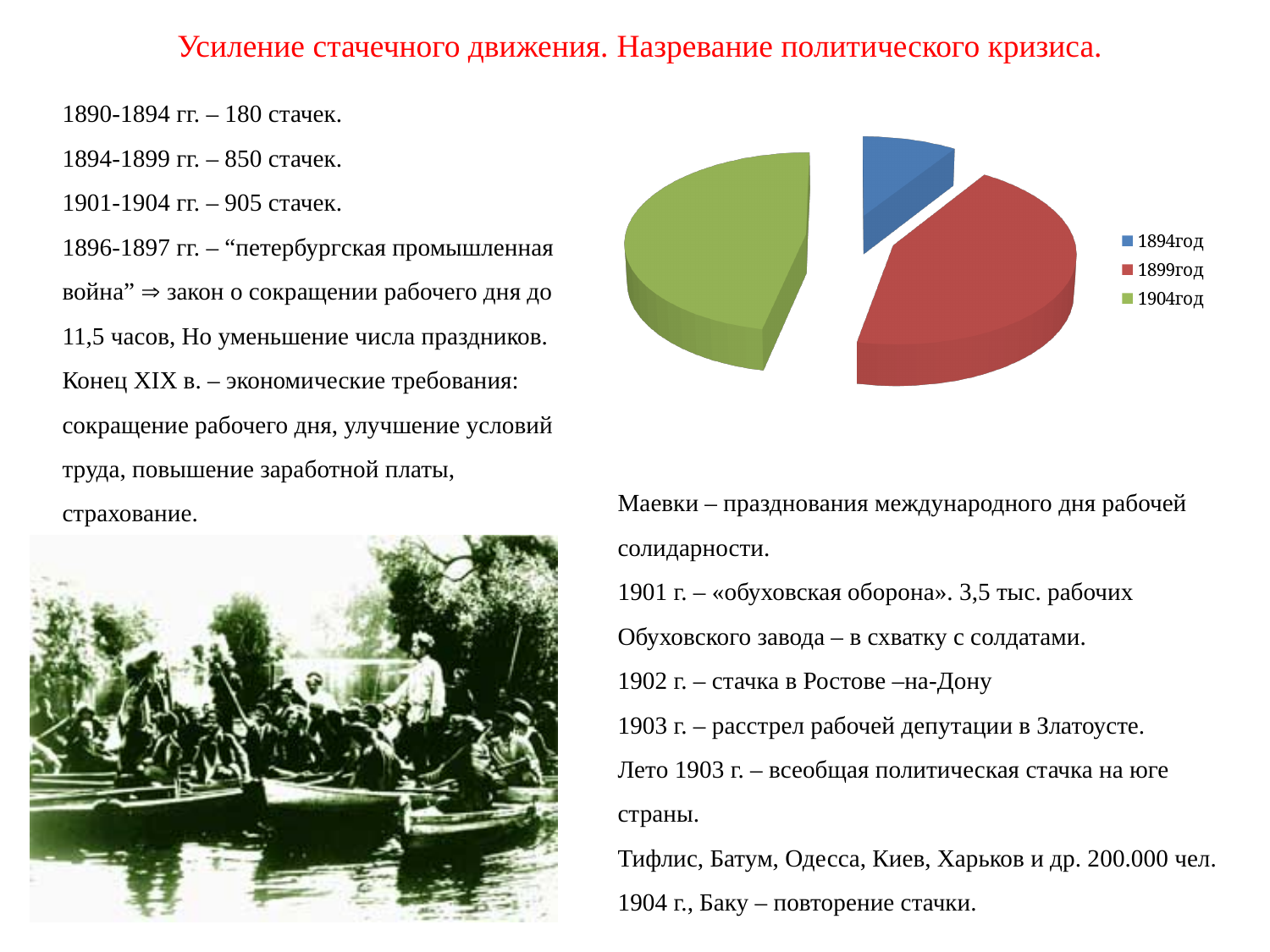
What colour is the 1894год slice in the pie chart? blue How many slices does the pie chart have? 3 Which slice is larger in the pie chart, 1894год or 1899год? 1899год What colour is the 1904год slice in the pie chart? green Which slice is larger in the pie chart, 1894год or 1904год? 1904год How many entries does the legend of the pie chart list? 3 Which category has the smallest slice in the pie chart? 1894год What kind of chart is shown on the slide? pie chart